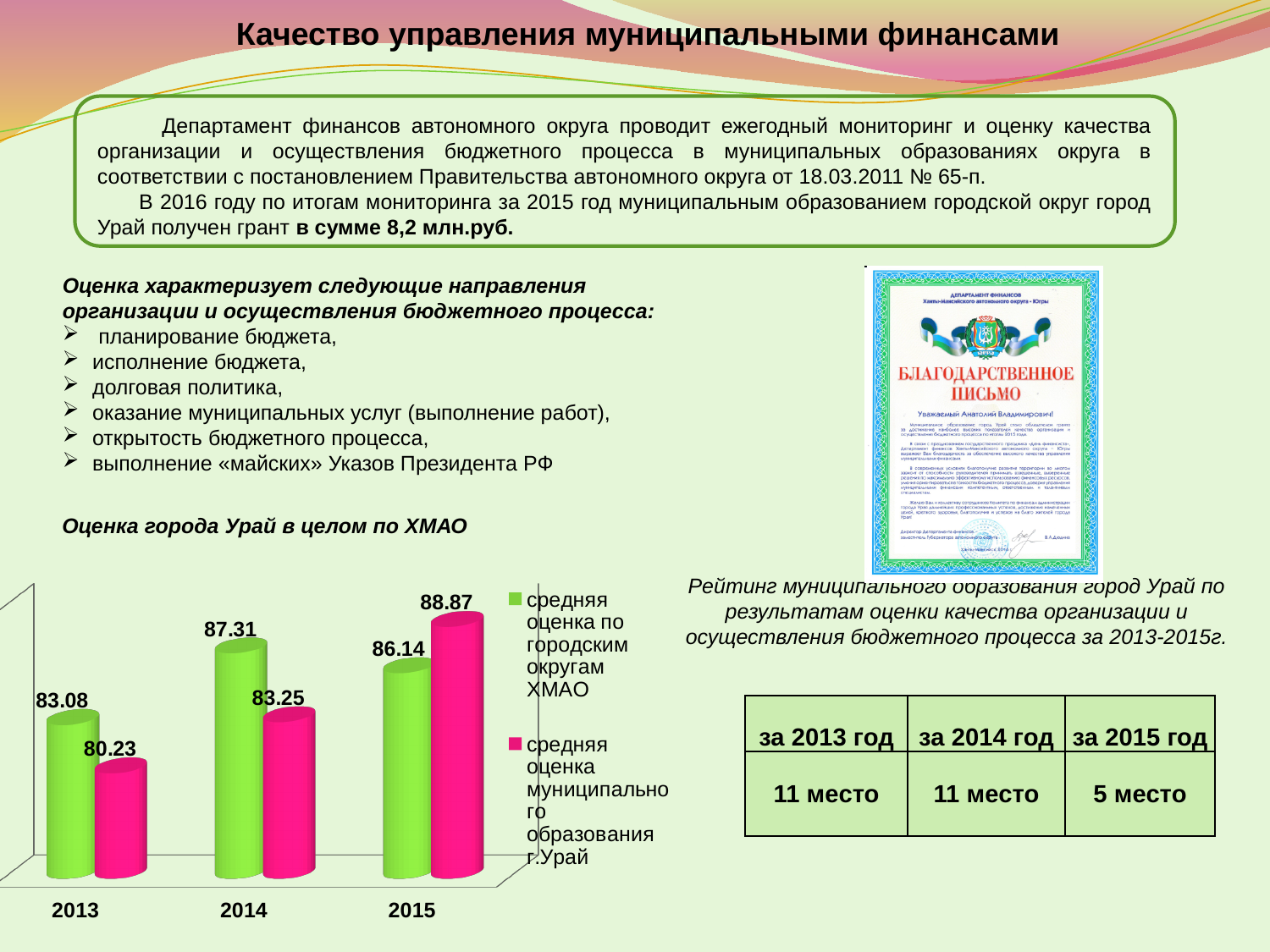
How many years are shown on the x axis of the chart? 3 Does the average score for the municipality of Uray rise or fall from 2013 to 2015? rise What is the average score for the municipality of Uray in 2014? 83.25 How many series does the chart legend list? 2 In 2014, which is larger: the average score for the city districts of KhMAO or the average score for Uray? the average score for the city districts of KhMAO In which year is the average score for the municipality of Uray the lowest? 2013 What is the difference between the KhMAO city districts score and the Uray score in 2013? 2.85 In which year is the average score for the city districts of KhMAO the highest? 2014 What is the average score for the municipality of Uray (г.Урай) in 2015? 88.87 What is the average score for the city districts of KhMAO in 2015? 86.14 What is the average score for the city districts of KhMAO (средняя оценка по городским округам ХМАО) in 2013? 83.08 What is the difference between the Uray score and the KhMAO city districts score in 2015? 2.73